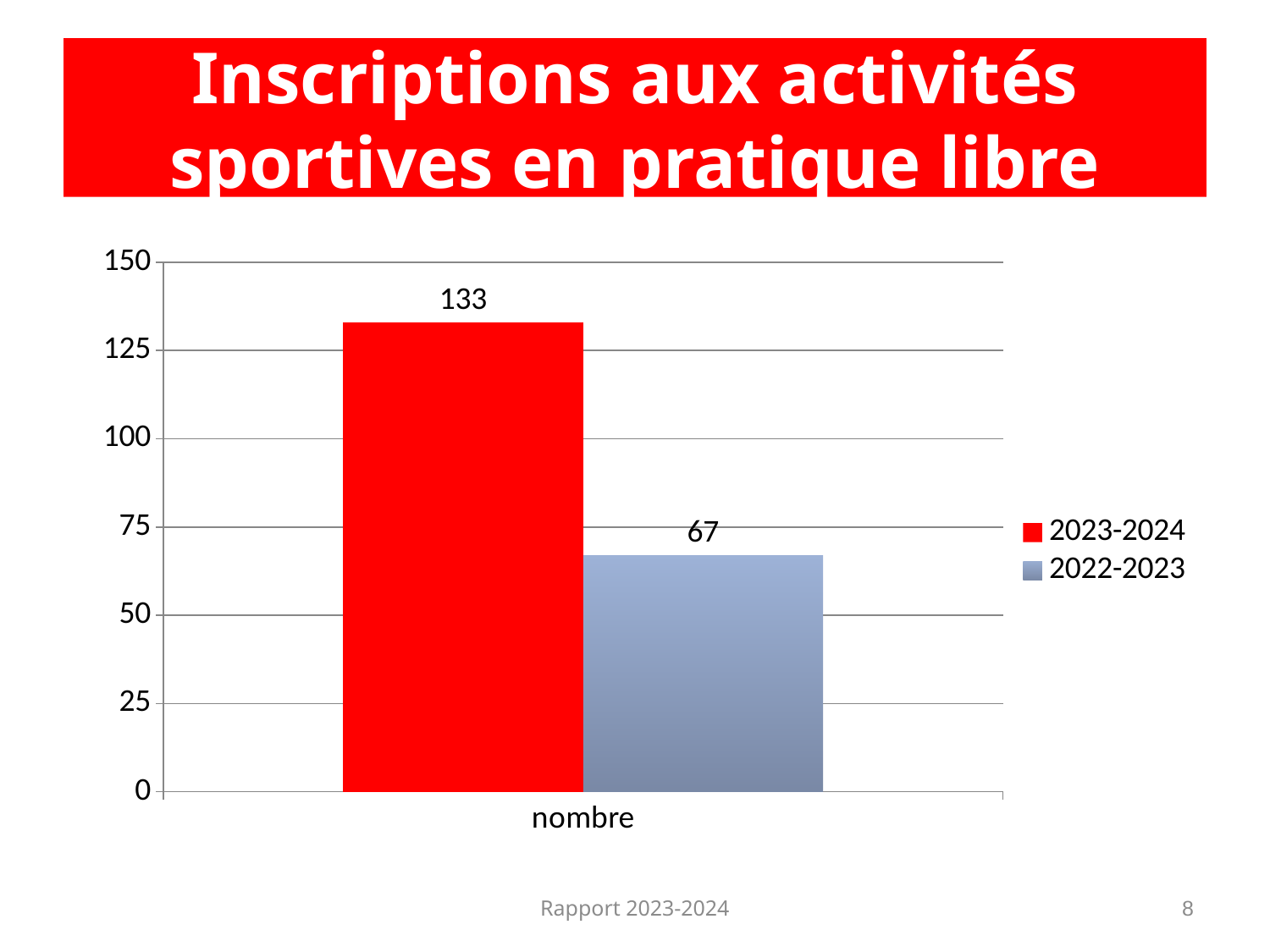
Which series has the lowest value? 2022-2023 What kind of chart is shown on the slide? bar chart What is the value for 2023-2024? 133 Is the value for 2023-2024 greater or less than 125? greater What is the category label shown on the x axis? nombre Is the value for 2022-2023 greater or less than 75? less How many series does the legend list? 2 How many categories are shown on the x axis? 1 Which series has the higher value, 2023-2024 or 2022-2023? 2023-2024 What is the value for 2022-2023? 67 What is the difference between the 2023-2024 value and the 2022-2023 value? 66 What colour is the bar for 2023-2024? red